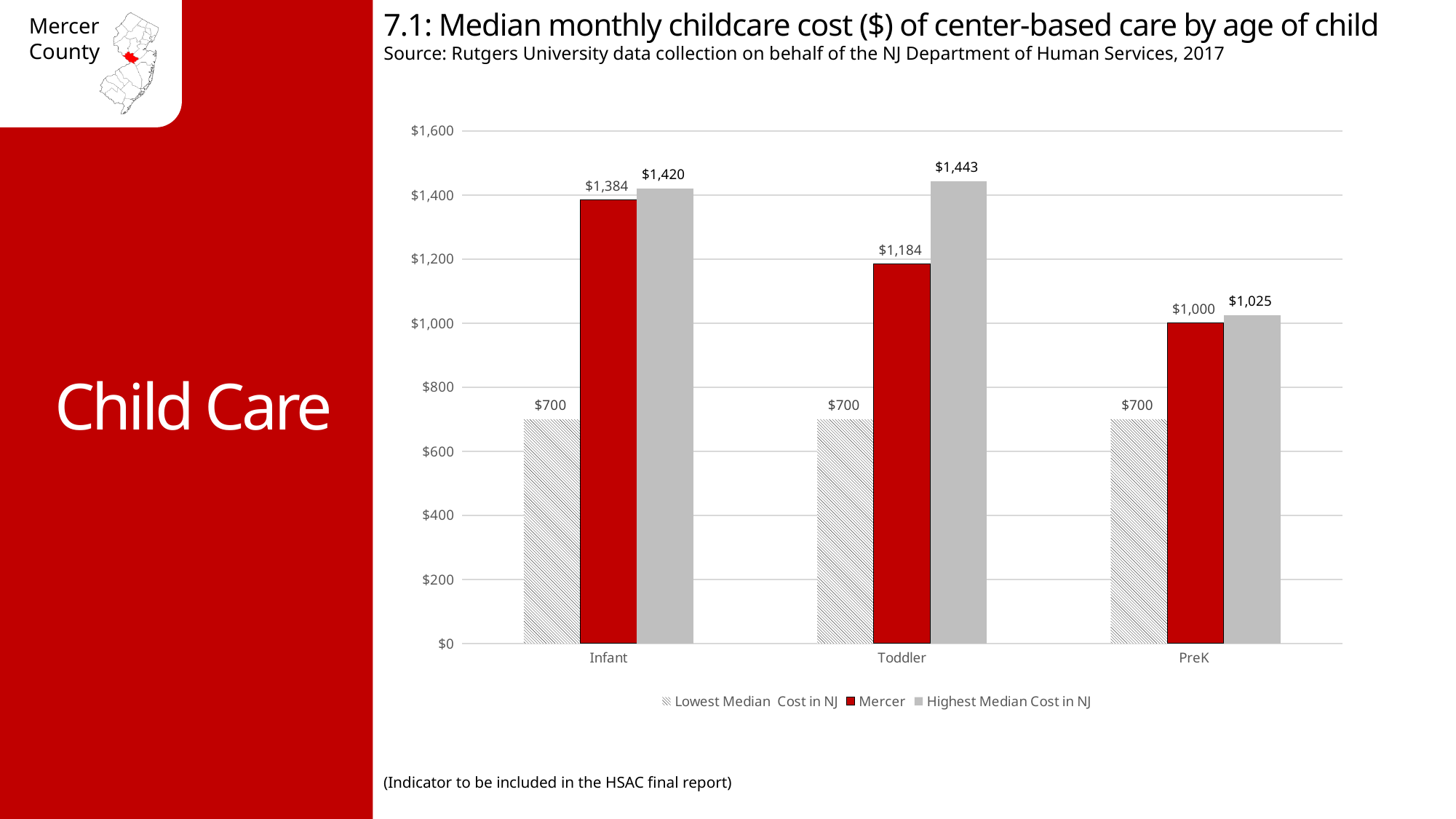
Which age group has the highest Mercer median monthly cost? Infant What is the Mercer median monthly childcare cost for Infant care? $1,384 What is the Highest Median Cost in NJ for Toddler care? $1,443 How many age groups are shown on the x axis? 3 What kind of chart is shown on the slide? Bar chart What is the Mercer median monthly cost for PreK care? $1,000 What is the difference between the Highest Median Cost in NJ and the Mercer cost for Infant care? $36 What is the difference between the Mercer cost for Toddler care and the Lowest Median Cost in NJ for Toddler care? $484 What is the Lowest Median Cost in NJ for PreK care? $700 Which is larger: the Mercer cost for Toddler care or the Mercer cost for PreK care? Toddler How many series does the legend list? 3 Which age group has the lowest Highest Median Cost in NJ? PreK